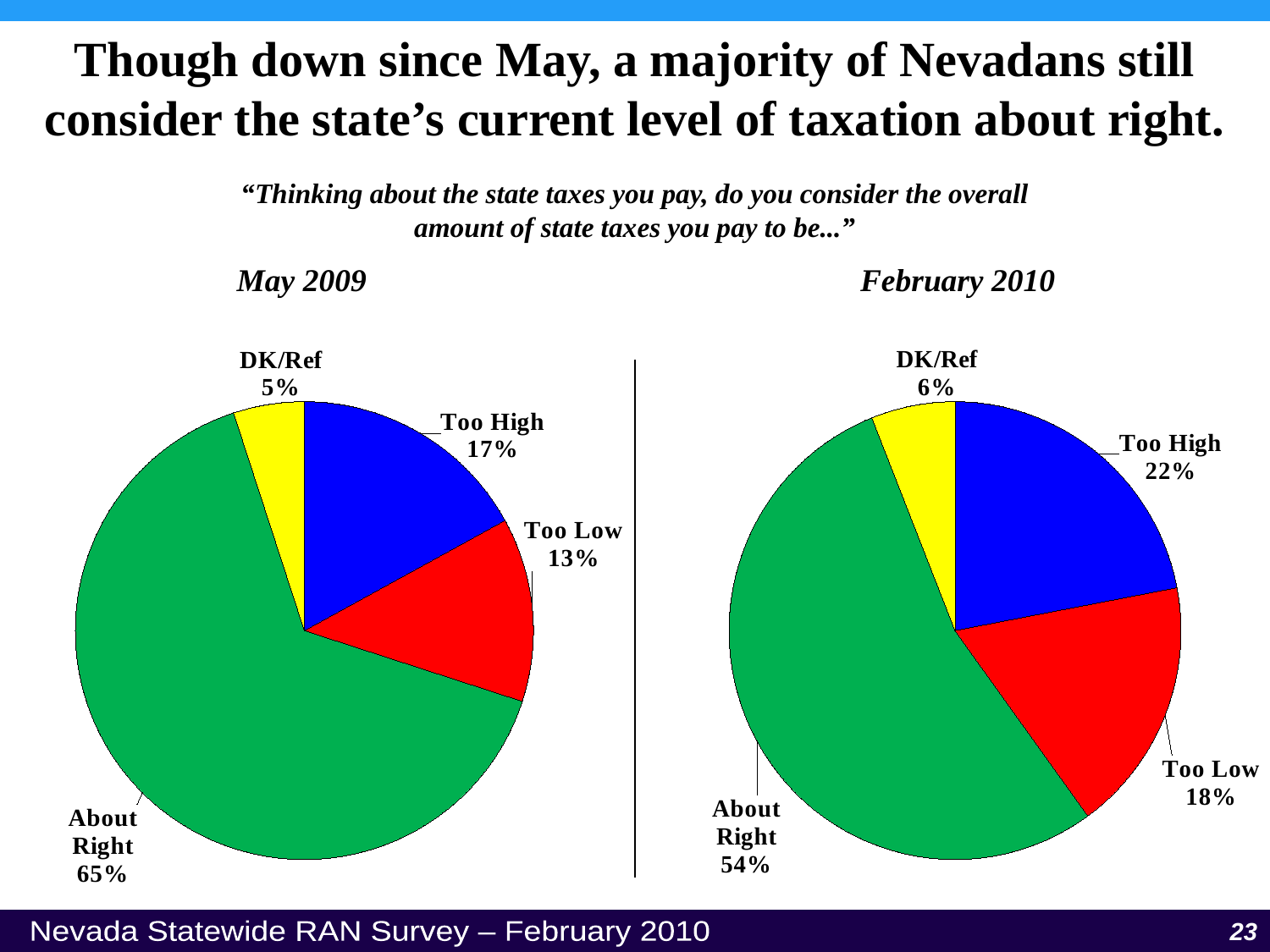
In the May 2009 pie chart, what share of respondents said the level of taxation is About Right? 65% In the February 2010 pie chart, which category has the largest slice? About Right In the February 2010 pie chart, which is larger: Too High or Too Low? Too High How much did the About Right share fall from the May 2009 chart to the February 2010 chart? 11 percentage points In the February 2010 pie chart, what colour is the About Right slice? Green In the May 2009 pie chart, what is the value for DK/Ref? 5% In the May 2009 pie chart, what is the difference between the Too High and Too Low shares? 4 percentage points What type of chart is used on this slide? Pie chart How many slices does the May 2009 pie chart have? 4 In the February 2010 pie chart, what is the value for Too Low? 18% In the February 2010 pie chart, what share of respondents said taxes are Too High? 22% In the May 2009 pie chart, which category has the smallest slice? DK/Ref